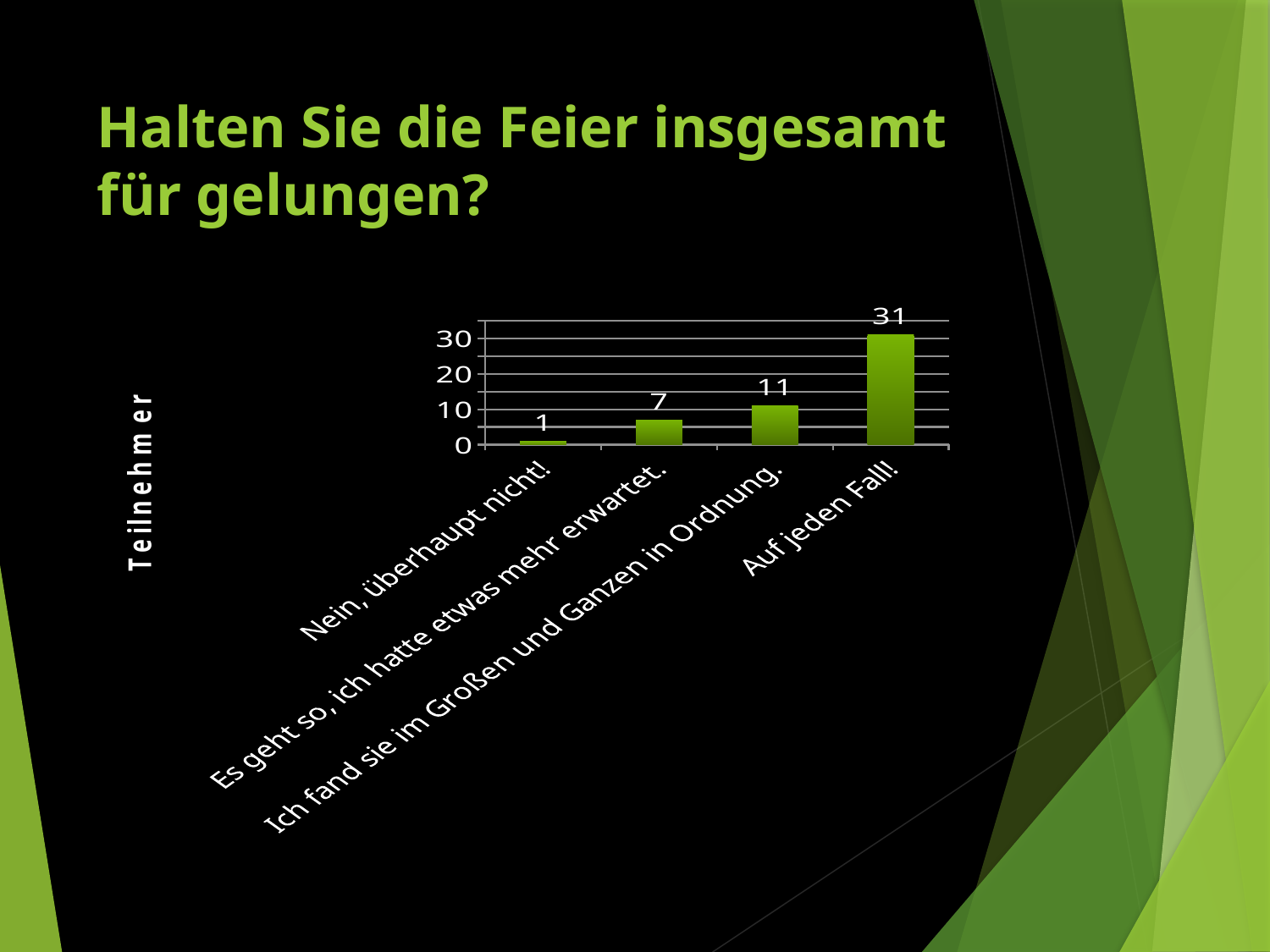
Which category has the highest value? Auf jeden Fall! Is the value for "Auf jeden Fall!" greater or less than 20? greater How many categories are shown on the x axis? 4 Do the values rise or fall from left to right along the x axis? rise What is the value for "Es geht so, ich hatte etwas mehr erwartet."? 7 Which is larger, the value for "Es geht so, ich hatte etwas mehr erwartet." or the value for "Ich fand sie im Großen und Ganzen in Ordnung."? Ich fand sie im Großen und Ganzen in Ordnung. Which category has the lowest value? Nein, überhaupt nicht! What is the value for "Ich fand sie im Großen und Ganzen in Ordnung."? 11 What kind of chart is shown on the slide? bar chart What is the value for "Auf jeden Fall!"? 31 What is the difference between the values for "Auf jeden Fall!" and "Ich fand sie im Großen und Ganzen in Ordnung."? 20 What is the value for "Nein, überhaupt nicht!"? 1